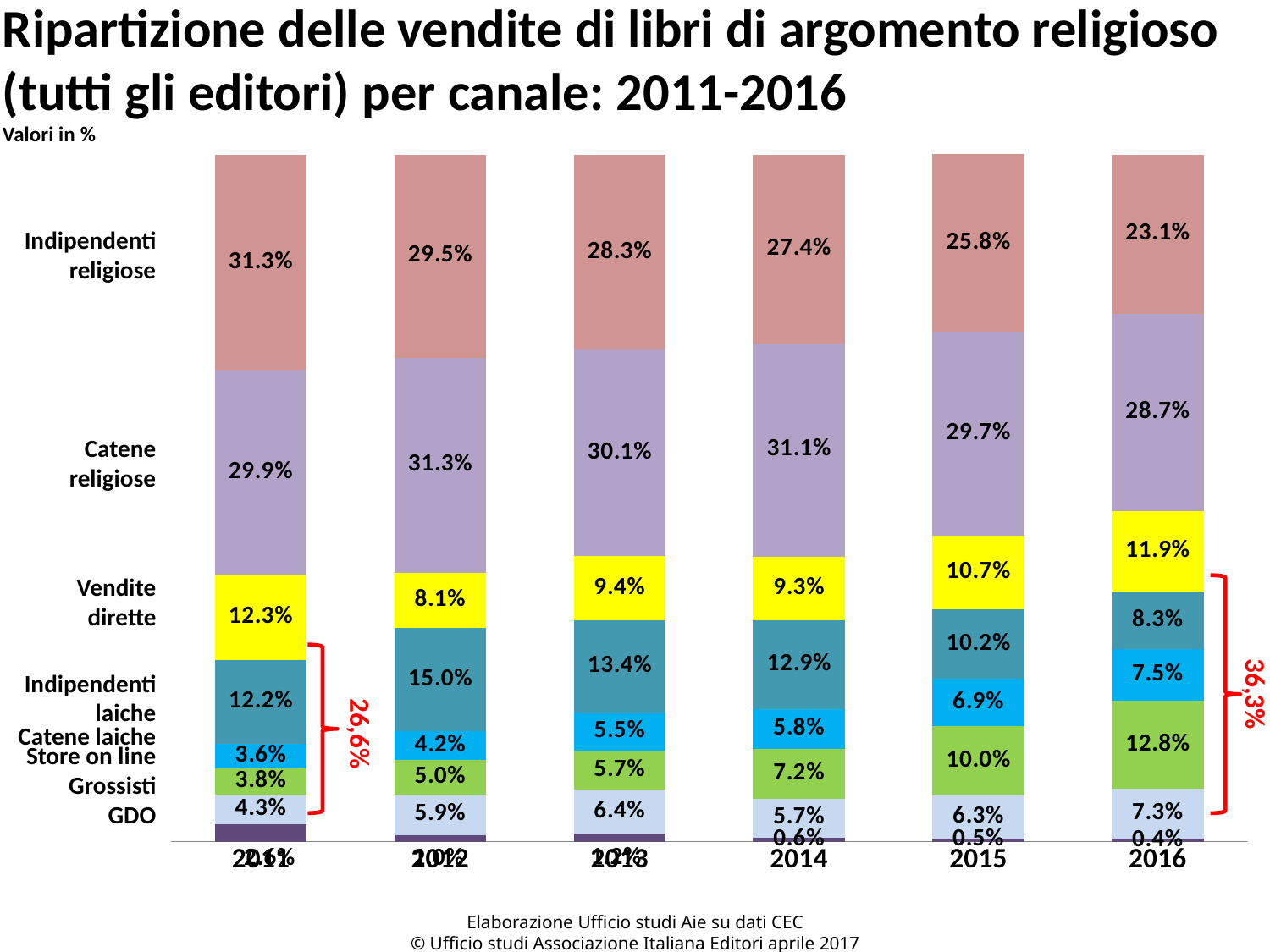
What is the value of the smallest (bottom) segment of the 2015 bar? 0.5% In which year is the Indipendenti religiose share lowest? 2016 How many years (bars) are shown on the x axis? 6 What kind of chart is shown on the slide? stacked bar chart In which year is the Vendite dirette share highest? 2011 What is the value for Catene religiose in 2014? 31.1% What is the value for Indipendenti religiose in 2011? 31.3% Which is larger in 2012: Catene religiose or Indipendenti religiose? Catene religiose Does the Indipendenti religiose share rise or fall from 2011 to 2016? fall What is the difference between the Indipendenti religiose value in 2011 and in 2016? 8.2% What is the value for Vendite dirette in 2016? 11.9% What percentage does the red bracket annotation next to the 2016 bar show? 36,3%